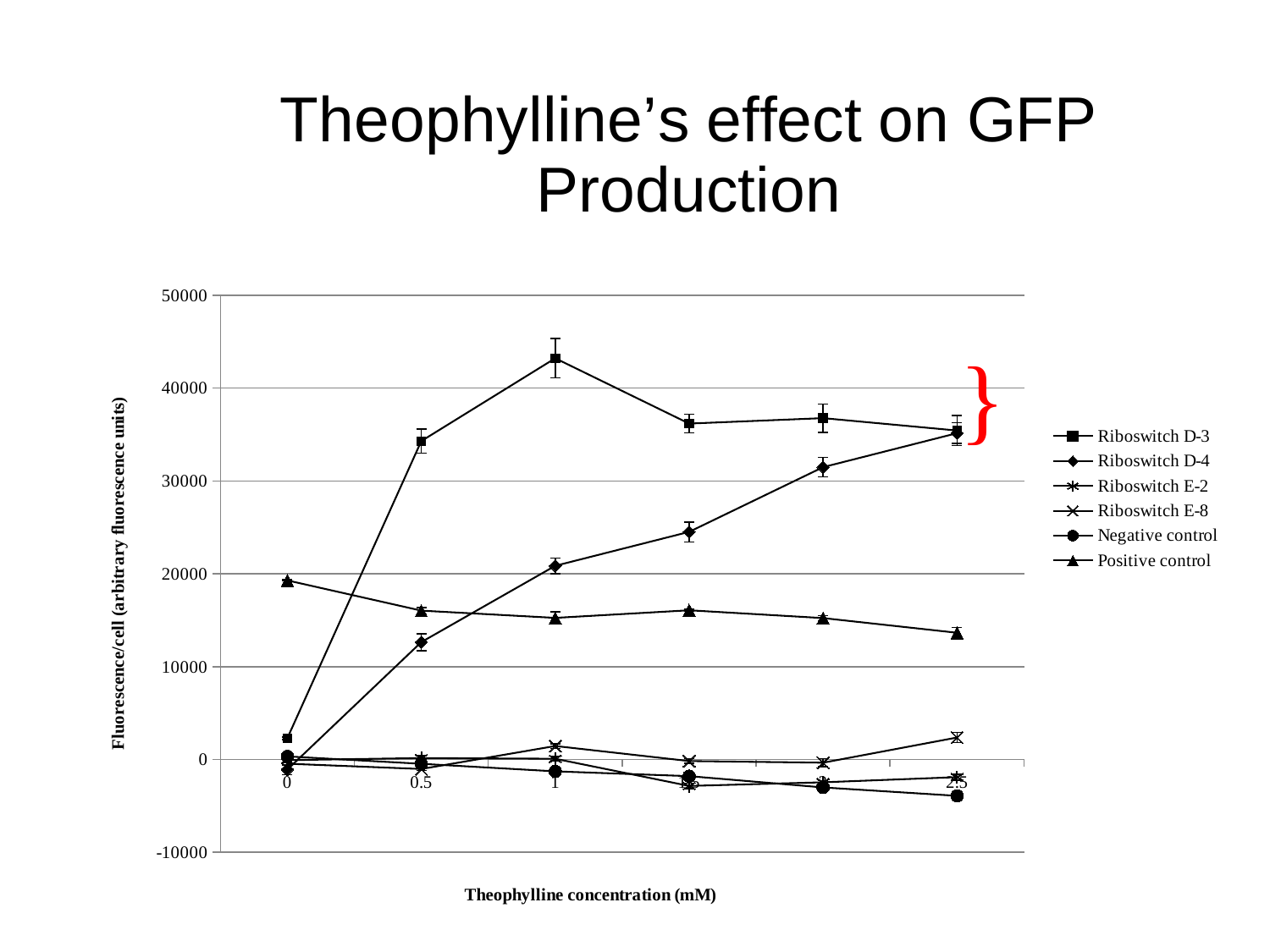
Does the Positive control series rise or fall as theophylline concentration increases from 0 to 2.5 mM? fall Is the value for Riboswitch D-3 at 1 mM greater or less than 40000? greater Which series has the highest value at 1 mM theophylline? Riboswitch D-3 Which series has the lowest value at 2.5 mM theophylline? Negative control What kind of chart is shown on the slide? line chart What is the title of the chart's x axis? Theophylline concentration (mM) At 0.5 mM, which is larger: Riboswitch D-3 or Positive control? Riboswitch D-3 How many series does the legend list? 6 Is the value for Riboswitch D-4 at 0.5 mM greater or less than 10000? greater Which series is plotted with triangle markers? Positive control Is the value for Negative control at 2.5 mM greater or less than 0? less